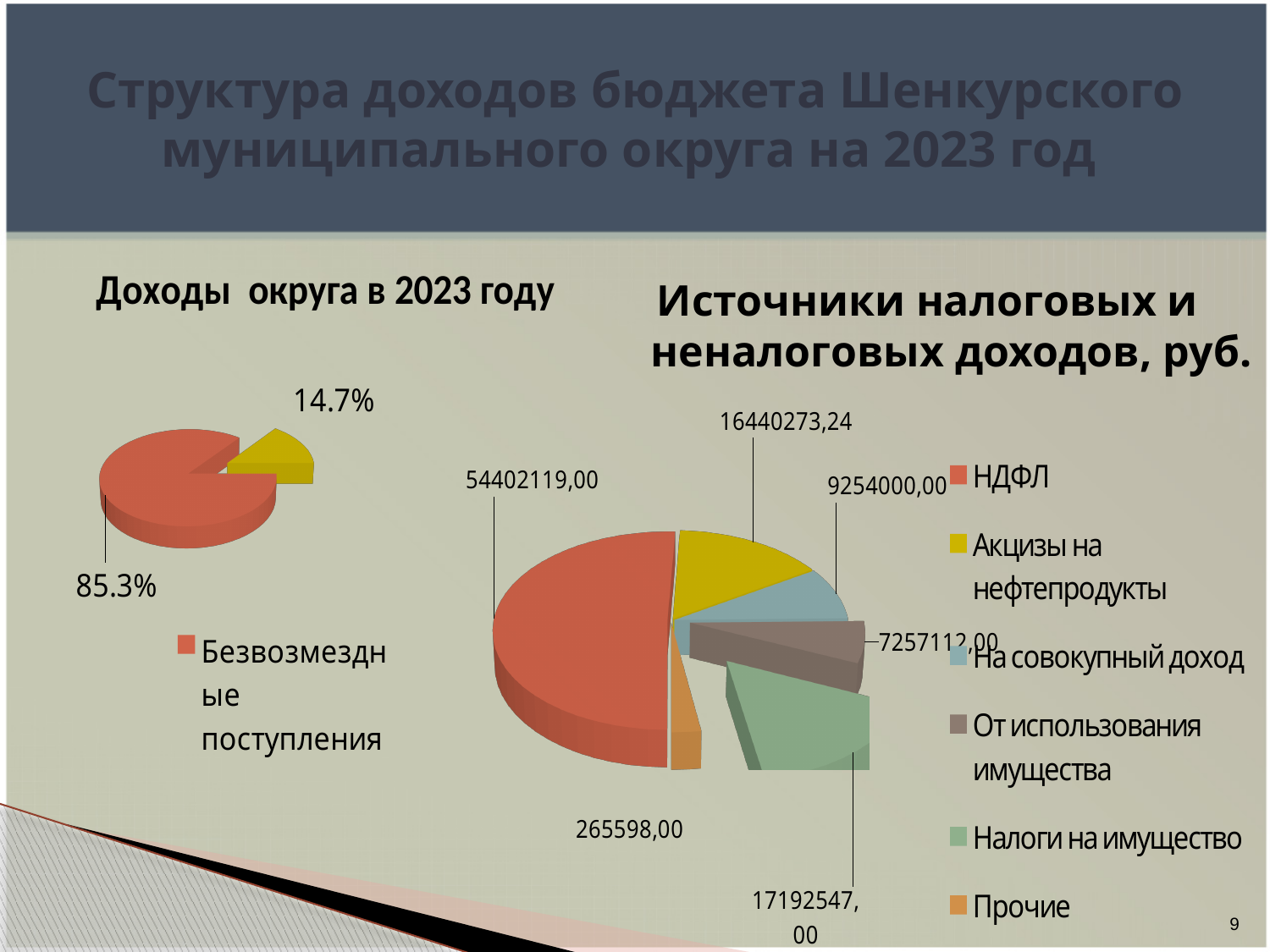
On the chart titled 'Доходы округа в 2023 году', how many slices does the pie have? 2 On the chart titled 'Источники налоговых и неналоговых доходов, руб.', what is the value for Акцизы на нефтепродукты? 16440273,24 On the chart titled 'Источники налоговых и неналоговых доходов, руб.', which category has the largest value? НДФЛ On the chart titled 'Источники налоговых и неналоговых доходов, руб.', what is the difference between Налоги на имущество and Акцизы на нефтепродукты? 752273,76 On the chart titled 'Доходы округа в 2023 году', what is the value shown for the smaller (yellow) slice? 14.7% What kind of chart is 'Доходы округа в 2023 году'? Pie chart On the chart titled 'Доходы округа в 2023 году', what share of the pie is Безвозмездные поступления? 85.3% On the chart titled 'Источники налоговых и неналоговых доходов, руб.', how many categories does the legend list? 6 On the chart titled 'Источники налоговых и неналоговых доходов, руб.', which category has the smallest value? Прочие On the chart titled 'Источники налоговых и неналоговых доходов, руб.', what is the value for НДФЛ? 54402119,00 On the chart titled 'Источники налоговых и неналоговых доходов, руб.', which is larger: На совокупный доход or От использования имущества? На совокупный доход On the chart titled 'Источники налоговых и неналоговых доходов, руб.', what is the value for Налоги на имущество? 17192547,00